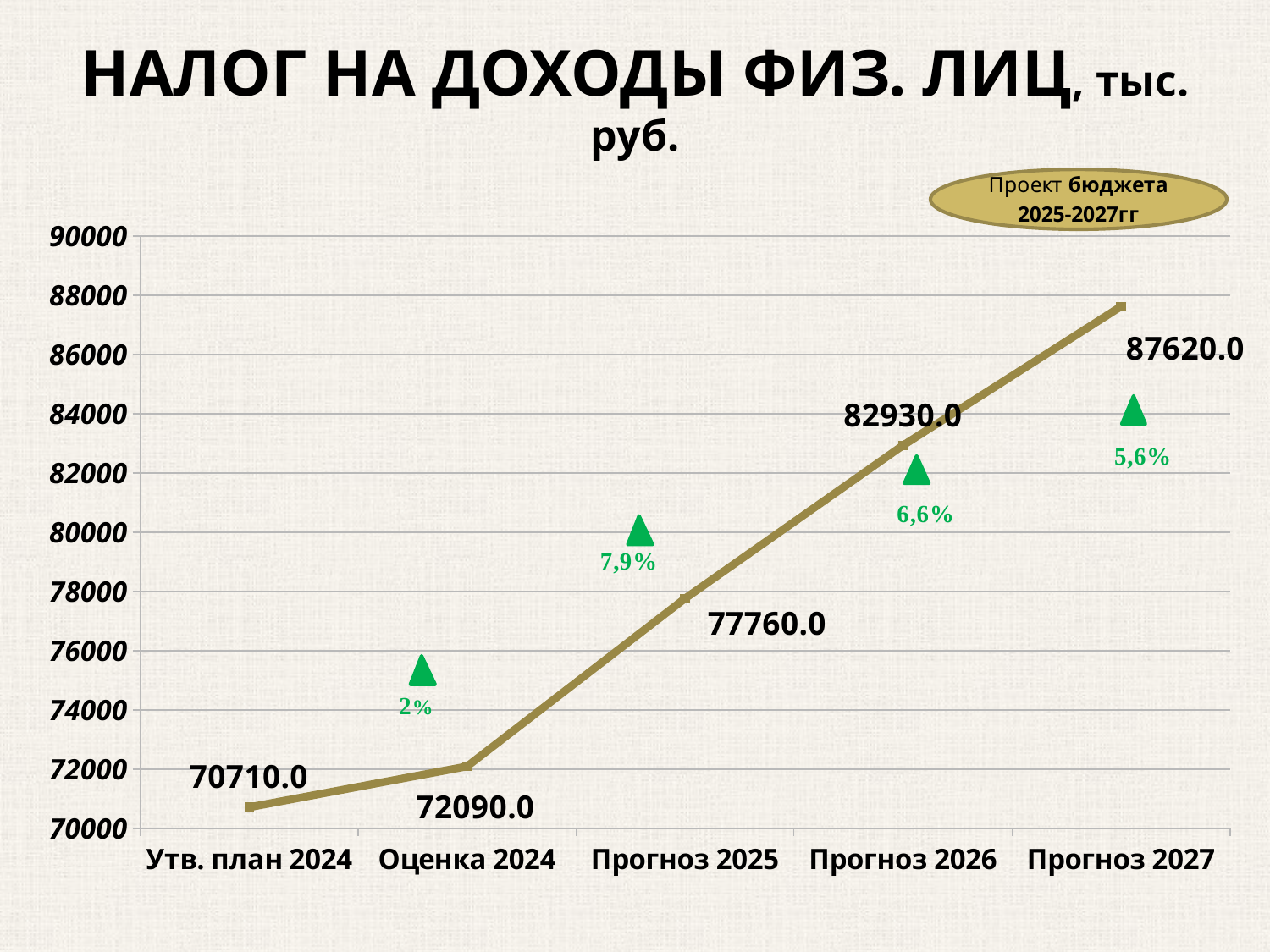
Is the value for Прогноз 2026 greater or less than 80000? greater Which category has the lowest value? Утв. план 2024 What is the difference between the values for Прогноз 2026 and Прогноз 2025? 5170.0 What is the difference between the values for Оценка 2024 and Утв. план 2024? 1380.0 Which category has the highest value? Прогноз 2027 Which is larger, the value for Оценка 2024 or the value for Прогноз 2026? Прогноз 2026 What kind of chart is shown on the slide? line chart What is the value for Прогноз 2027? 87620.0 Do the values rise or fall from Утв. план 2024 to Прогноз 2027? rise What is the value for Прогноз 2025? 77760.0 What is the value for Утв. план 2024? 70710.0 How many categories are shown on the x axis? 5